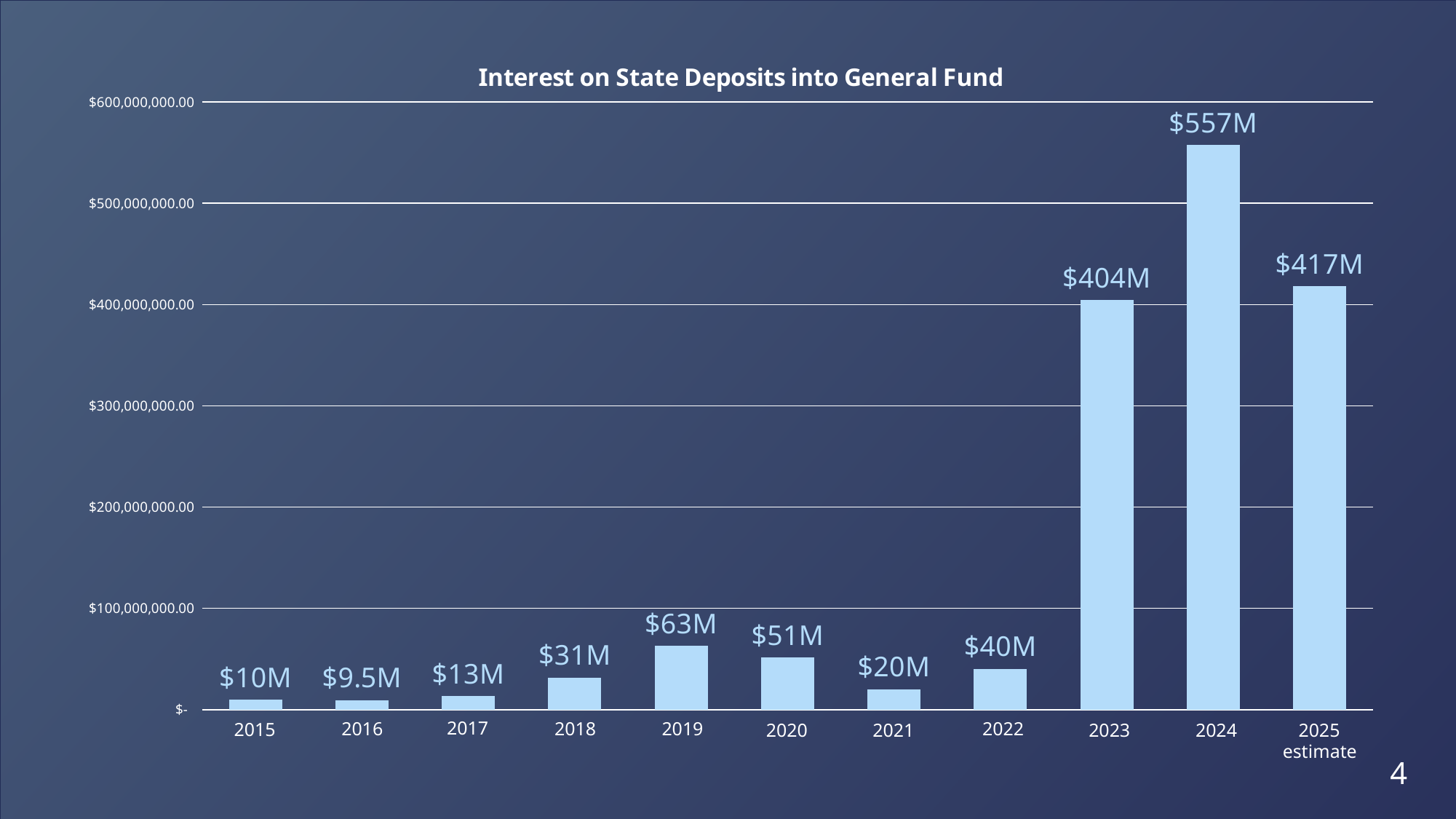
What kind of chart is this? bar chart Which year has the highest value? 2024 How many years are shown on the x axis? 11 Do the values rise or fall from 2019 to 2021? fall Which year has the lowest value? 2016 What is the value for the 2025 estimate? $417M Is the value for 2023 greater or less than $300,000,000.00? greater What is the value for 2019? $63M Which is larger, the value for 2020 or the value for 2022? 2020 What is the value for 2024? $557M What is the difference between the values for 2024 and 2023? $153M What is the title of the chart? Interest on State Deposits into General Fund